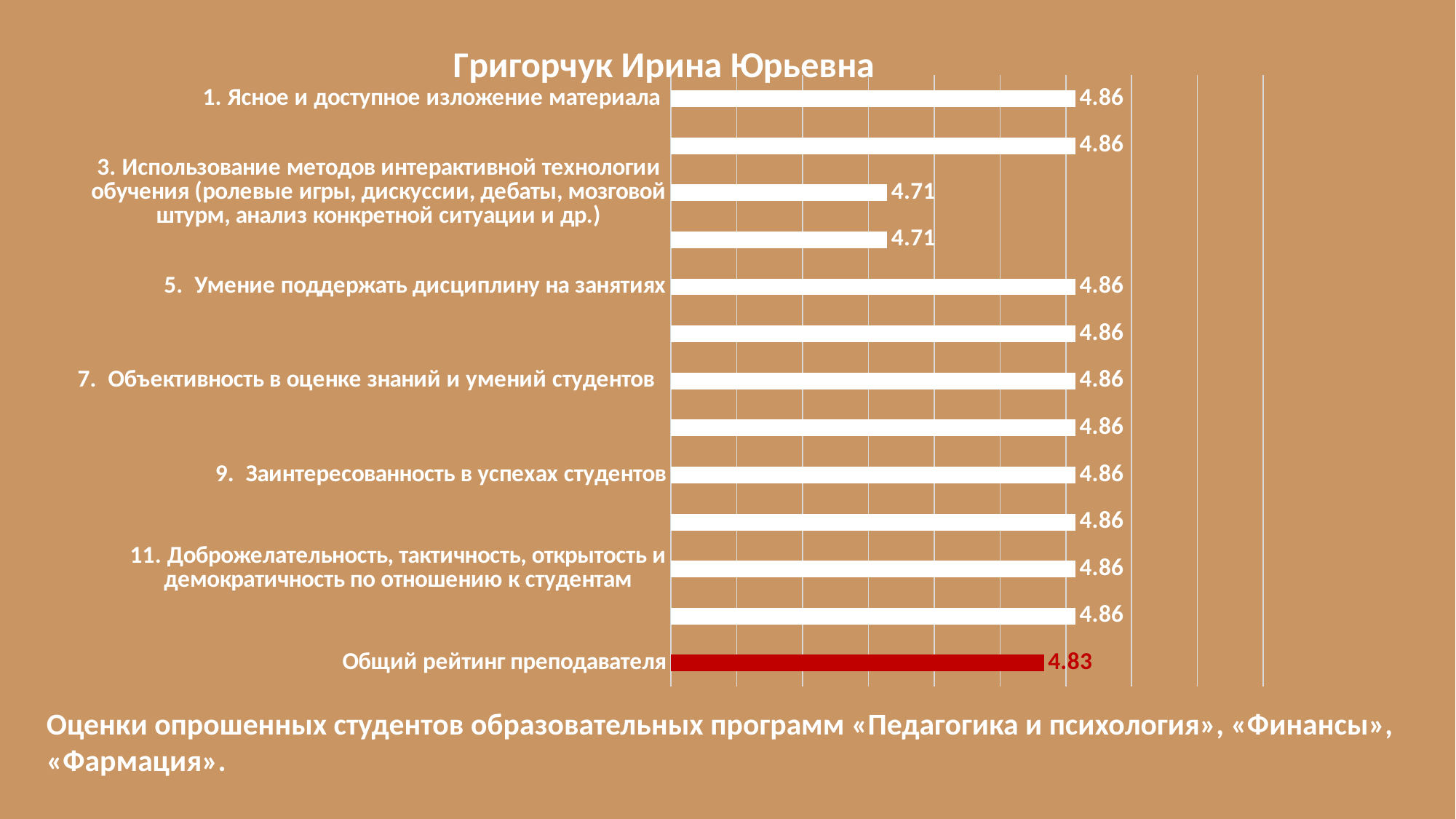
What is the difference between the value for "1. Ясное и доступное изложение материала" and the value for "3. Использование методов интерактивной технологии обучения"? 0.15 Which is larger: the value for "9. Заинтересованность в успехах студентов" or the value for "Общий рейтинг преподавателя"? 9. Заинтересованность в успехах студентов What is the difference between the value for "5. Умение поддержать дисциплину на занятиях" and the value for "Общий рейтинг преподавателя"? 0.03 What is the value for "7. Объективность в оценке знаний и умений студентов"? 4.86 How many bars are plotted in the chart? 13 What is the value for "3. Использование методов интерактивной технологии обучения (ролевые игры, дискуссии, дебаты, мозговой штурм, анализ конкретной ситуации и др.)"? 4.71 What is the value for "11. Доброжелательность, тактичность, открытость и демократичность по отношению к студентам"? 4.86 What is the value for "5. Умение поддержать дисциплину на занятиях"? 4.86 What is the value for "Общий рейтинг преподавателя"? 4.83 What is the value for "1. Ясное и доступное изложение материала"? 4.86 What kind of chart is shown on the slide? Bar chart What is the title of the chart? Григорчук Ирина Юрьевна